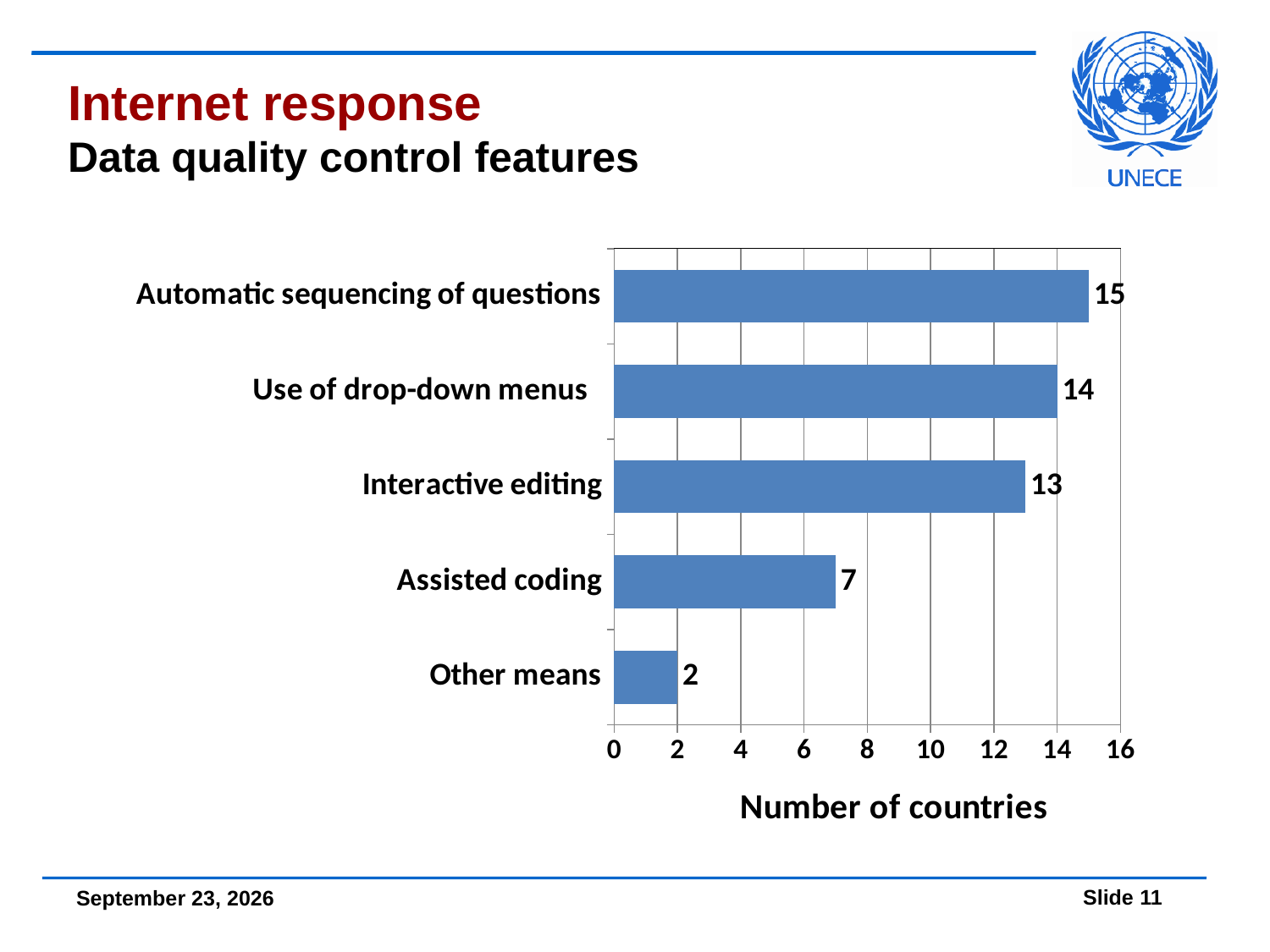
What is the number of countries for 'Use of drop-down menus'? 14 Which category has the lowest number of countries? Other means What is the value for 'Other means'? 2 What is the label of the horizontal axis? Number of countries What is the value for 'Interactive editing'? 13 How many countries use automatic sequencing of questions? 15 What is the difference between the number of countries for 'Interactive editing' and 'Assisted coding'? 6 Which data quality control feature has the highest number of countries? Automatic sequencing of questions How many countries reported 'Assisted coding'? 7 What kind of chart is shown on the slide? Bar chart Which has more countries: 'Use of drop-down menus' or 'Assisted coding'? Use of drop-down menus How many categories are shown in the chart? 5